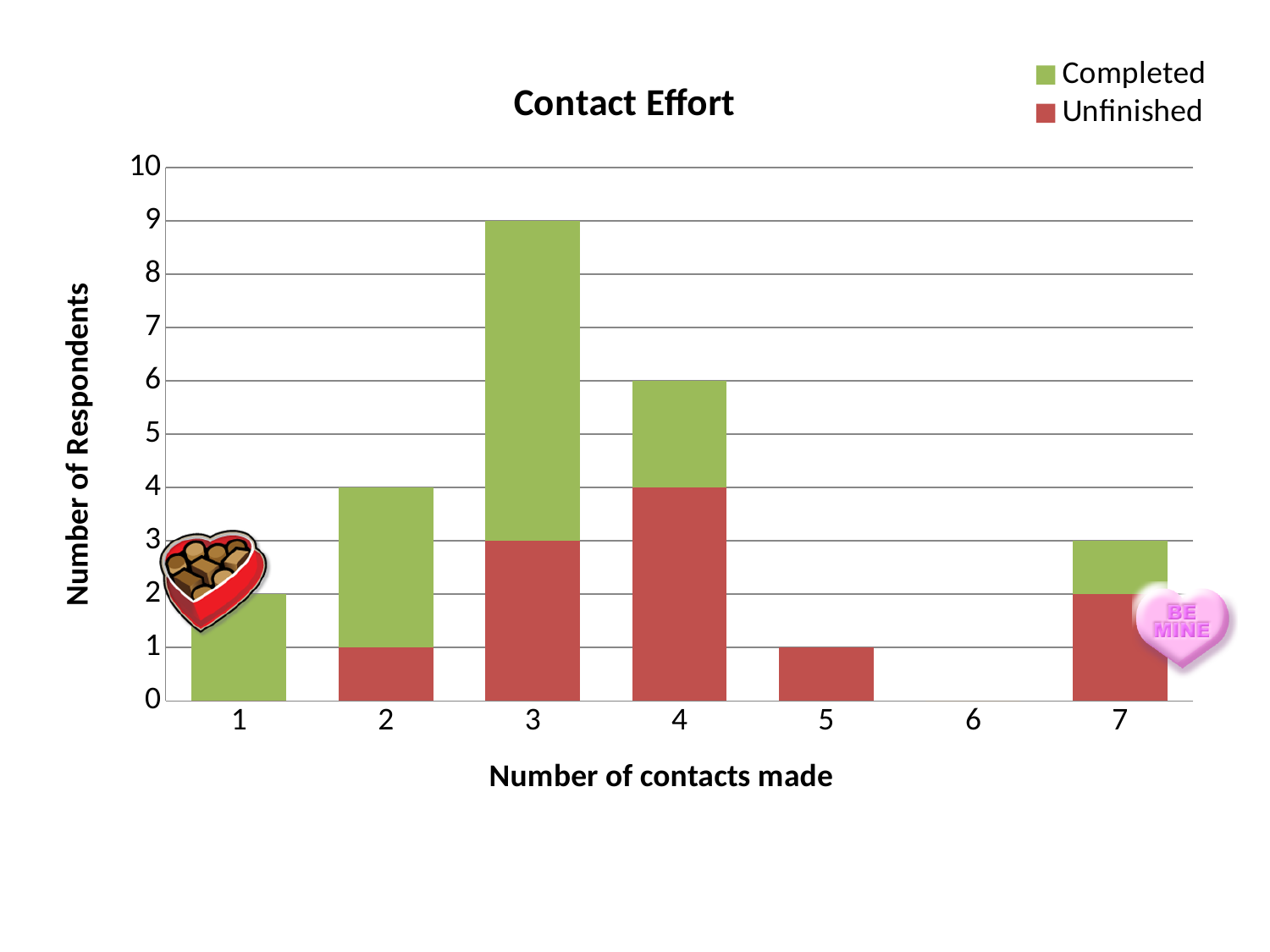
How many series does the legend list? 2 What kind of chart is shown on the slide? stacked bar chart What is the Unfinished value for 4 contacts made? 4 What is the total height of the stacked bar for 4 contacts made? 6 How many categories are shown on the x axis? 7 What is the title of the chart? Contact Effort What is the Completed value for 1 contact made? 2 Which number of contacts made has the tallest stacked bar? 3 What is the total height of the stacked bar for 3 contacts made? 9 Is the total stacked bar for 2 contacts made larger or smaller than the total for 7 contacts made? larger Which number of contacts made has no bar at all? 6 What is the difference between the total stacked bar for 3 contacts made and the total for 4 contacts made? 3